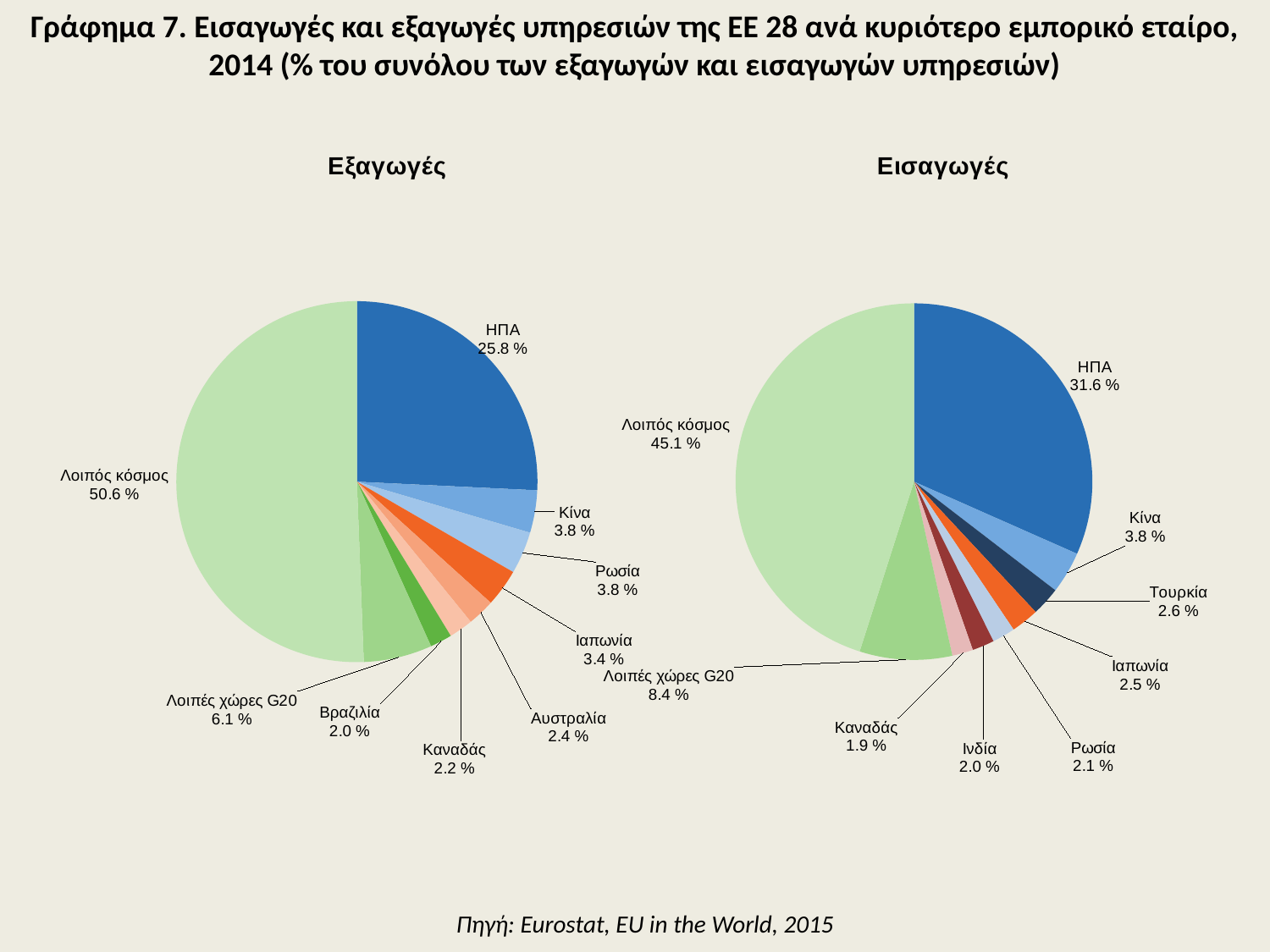
What is the difference between the ΗΠΑ share in the Εισαγωγές chart and the ΗΠΑ share in the Εξαγωγές chart? 5.8 % What source is cited at the bottom of the slide? Eurostat, EU in the World, 2015 How many slices does the Εισαγωγές pie chart have? 9 In the Εξαγωγές pie chart, which category has the largest slice? Λοιπός κόσμος In the Εξαγωγές pie chart, what share is shown for ΗΠΑ? 25.8 % In the Εισαγωγές pie chart, which category has the smallest slice? Καναδάς In the Εξαγωγές pie chart, which is larger: the share for Ιαπωνία or the share for Αυστραλία? Ιαπωνία In the Εξαγωγές pie chart, which category has the smallest slice? Βραζιλία What type of chart is used for Εξαγωγές and Εισαγωγές on this slide? Pie chart In the Εξαγωγές pie chart, what share is shown for Λοιπός κόσμος? 50.6 % In the Εισαγωγές pie chart, what share is shown for Τουρκία? 2.6 % In the Εισαγωγές pie chart, what share is shown for ΗΠΑ? 31.6 %